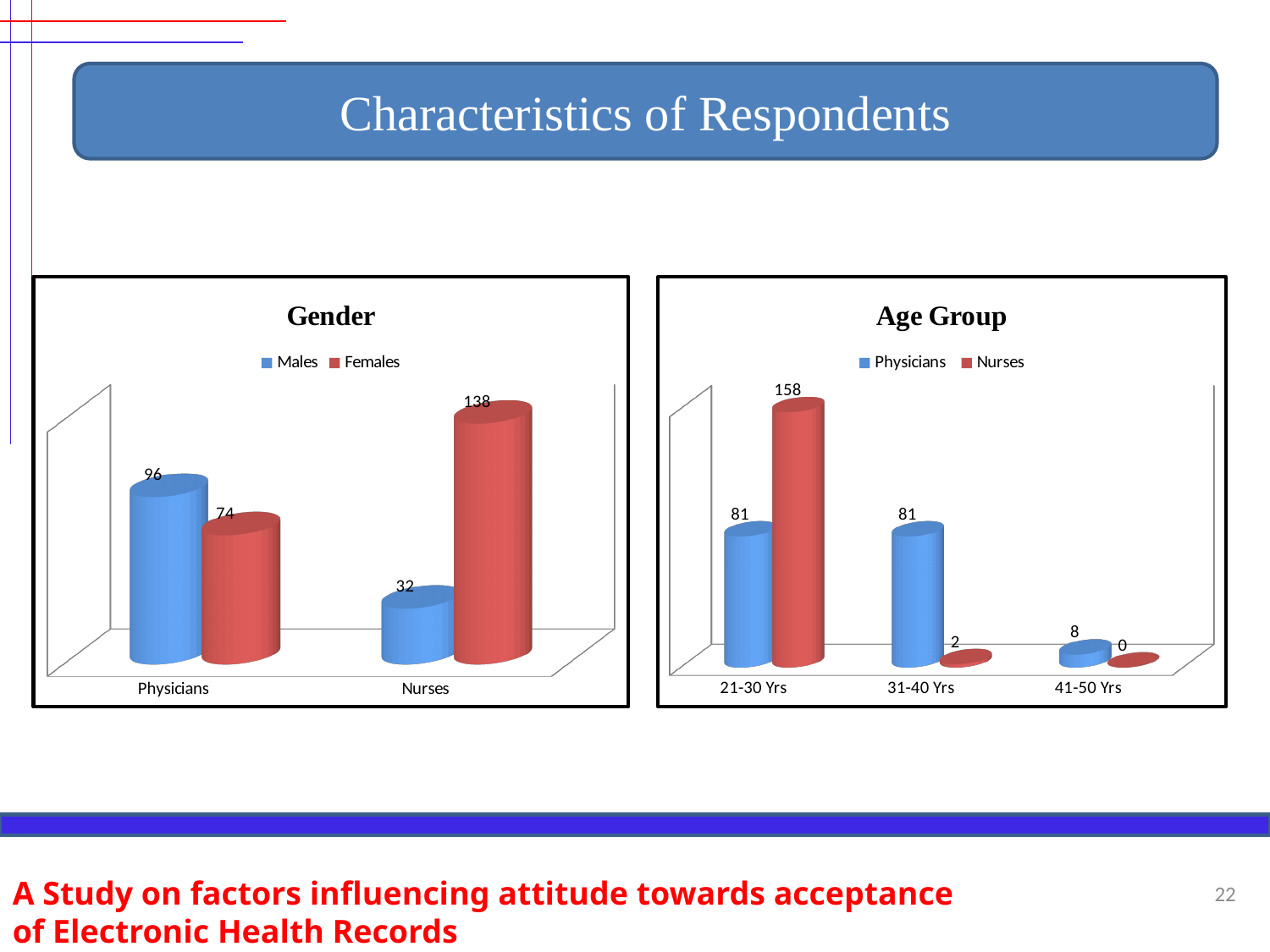
In the Gender chart, what is the value for Males among Physicians? 96 What kind of chart is the Age Group chart? bar chart In the Age Group chart, what is the value for Nurses in the 21-30 Yrs group? 158 In the Gender chart, which is larger among Nurses, Males or Females? Females In the Gender chart, how many series does the legend list? 2 In the Age Group chart, what is the value for Physicians in the 41-50 Yrs group? 8 In the Gender chart, what is the difference between Females and Males among Physicians? 22 In the Age Group chart, do the values for Nurses rise or fall from 21-30 Yrs to 41-50 Yrs? fall In the Age Group chart, what is the difference between Nurses and Physicians in the 21-30 Yrs group? 77 In the Gender chart, what is the value for Females among Nurses? 138 In the Age Group chart, how many age group categories are shown? 3 In the Age Group chart, which age group has the lowest value for Nurses? 41-50 Yrs